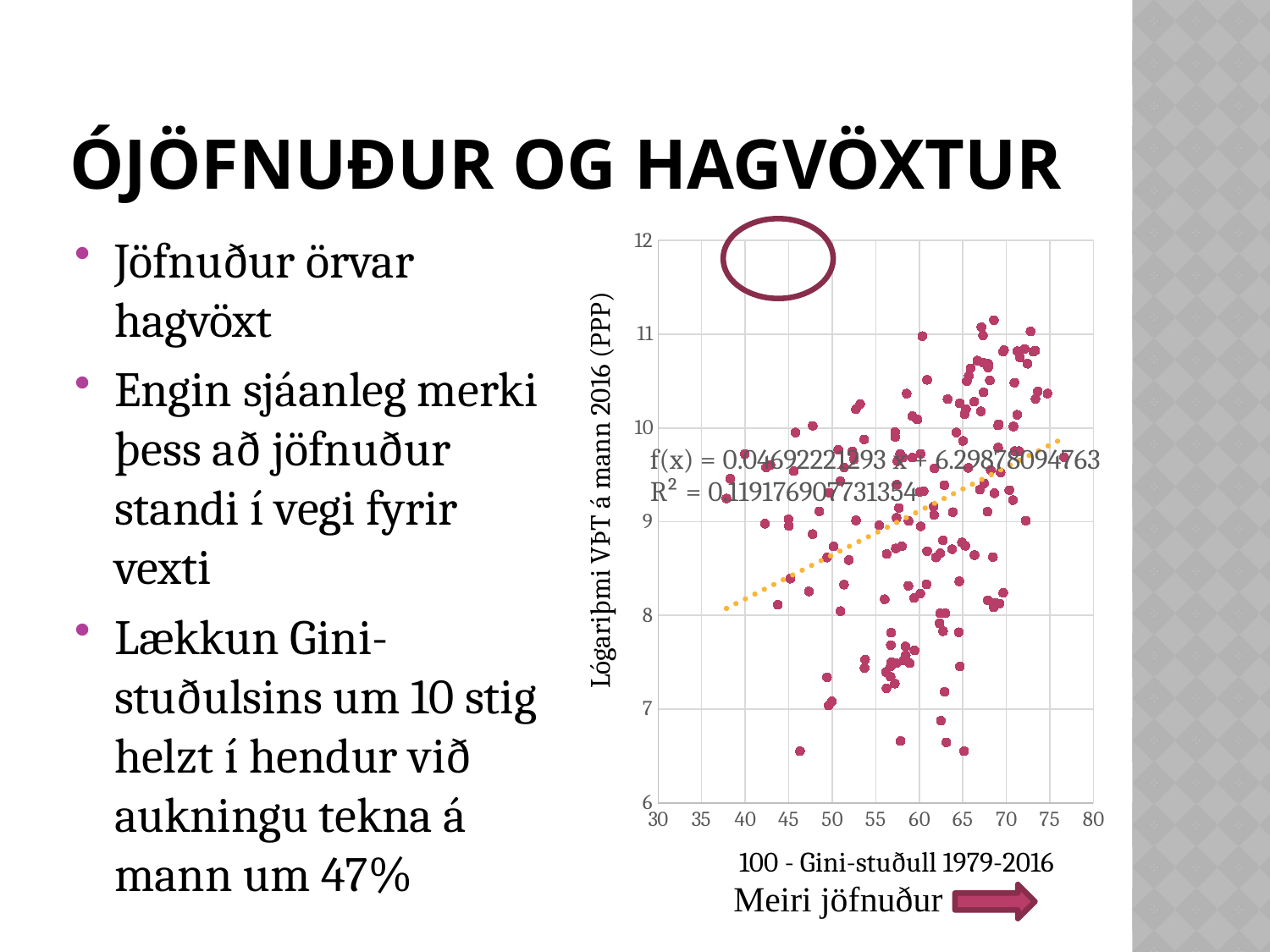
Is the trendline's value at x = 75 greater or less than 9? greater What is the lowest tick value shown on the y axis of the chart? 6 What is the title of the x axis of the chart? 100 - Gini-stuðull 1979-2016 What kind of chart is shown on the slide? scatter chart Does the dotted trendline in the chart rise or fall as the x-axis value increases? rise What is the lowest tick value shown on the x axis of the chart? 30 Is the trendline's value at x = 40 greater or less than 9? less Is the R² value printed on the chart greater or less than 0.5? less What is the highest tick value shown on the x axis of the chart? 80 What is the highest tick value shown on the y axis of the chart? 12 What is the title of the y axis of the chart? Lógariþmi VÞT á mann 2016 (PPP)